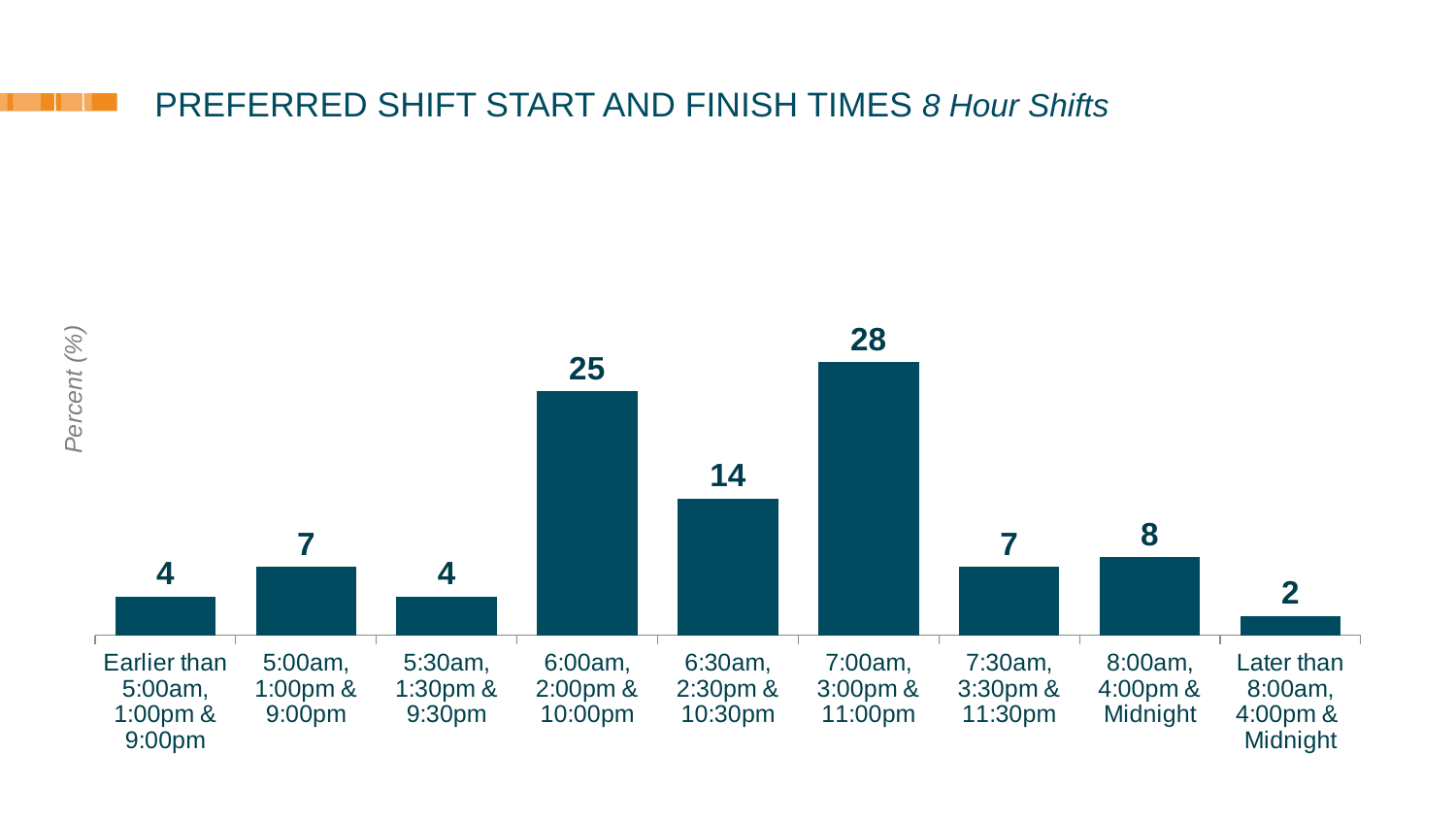
What kind of chart is shown on the slide? Bar chart What is the value for the 6:00am, 2:00pm & 10:00pm category? 25 What is the difference between the values for 7:00am, 3:00pm & 11:00pm and 6:00am, 2:00pm & 10:00pm? 3 What is the value for the 7:00am, 3:00pm & 11:00pm shift start and finish times? 28 What is the label on the vertical axis of the chart? Percent (%) Which has a larger value: 5:00am, 1:00pm & 9:00pm or 8:00am, 4:00pm & Midnight? 8:00am, 4:00pm & Midnight What is the value for the 'Later than 8:00am, 4:00pm & Midnight' category? 2 Which shift start and finish time category has the highest value? 7:00am, 3:00pm & 11:00pm What is the difference between the values for 6:30am, 2:30pm & 10:30pm and 8:00am, 4:00pm & Midnight? 6 What is the value for the 6:30am, 2:30pm & 10:30pm category? 14 Which shift start and finish time category has the lowest value? Later than 8:00am, 4:00pm & Midnight How many shift start and finish time categories are shown on the chart? 9